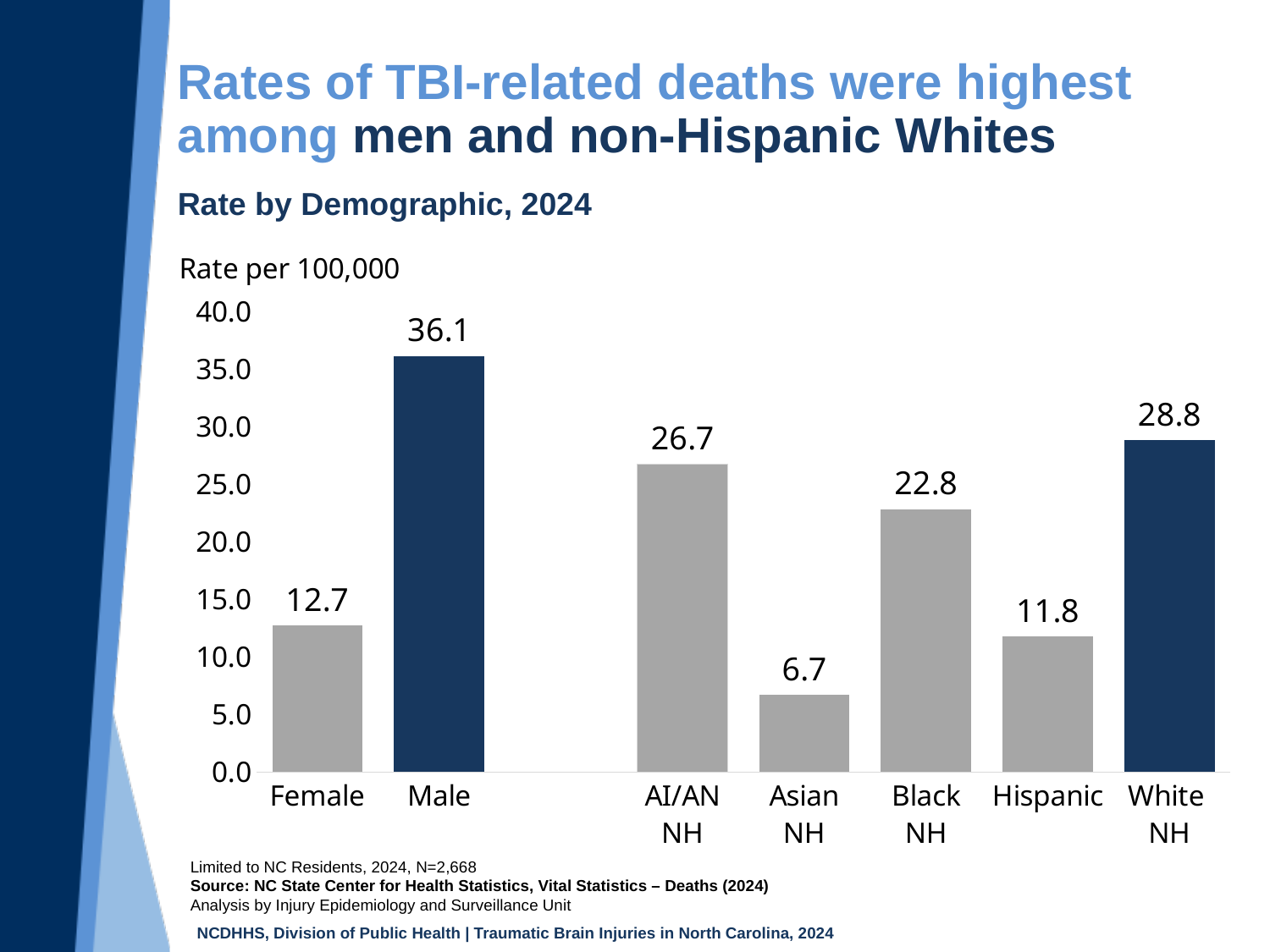
What is the TBI-related death rate per 100,000 for Asian NH? 6.7 What kind of chart is shown on the slide? Bar chart Which has a higher rate, AI/AN NH or Black NH? AI/AN NH Which category has the lowest TBI-related death rate? Asian NH Which category has the highest TBI-related death rate? Male What is the difference between the Male and Female rates? 23.4 What is the TBI-related death rate per 100,000 for Hispanic? 11.8 What is the difference between the White NH and Black NH rates? 6.0 Is the value for Female greater or less than 15.0? less What is the unit label shown above the chart's y axis? Rate per 100,000 What is the TBI-related death rate per 100,000 for Male? 36.1 How many categories are shown in the chart? 7